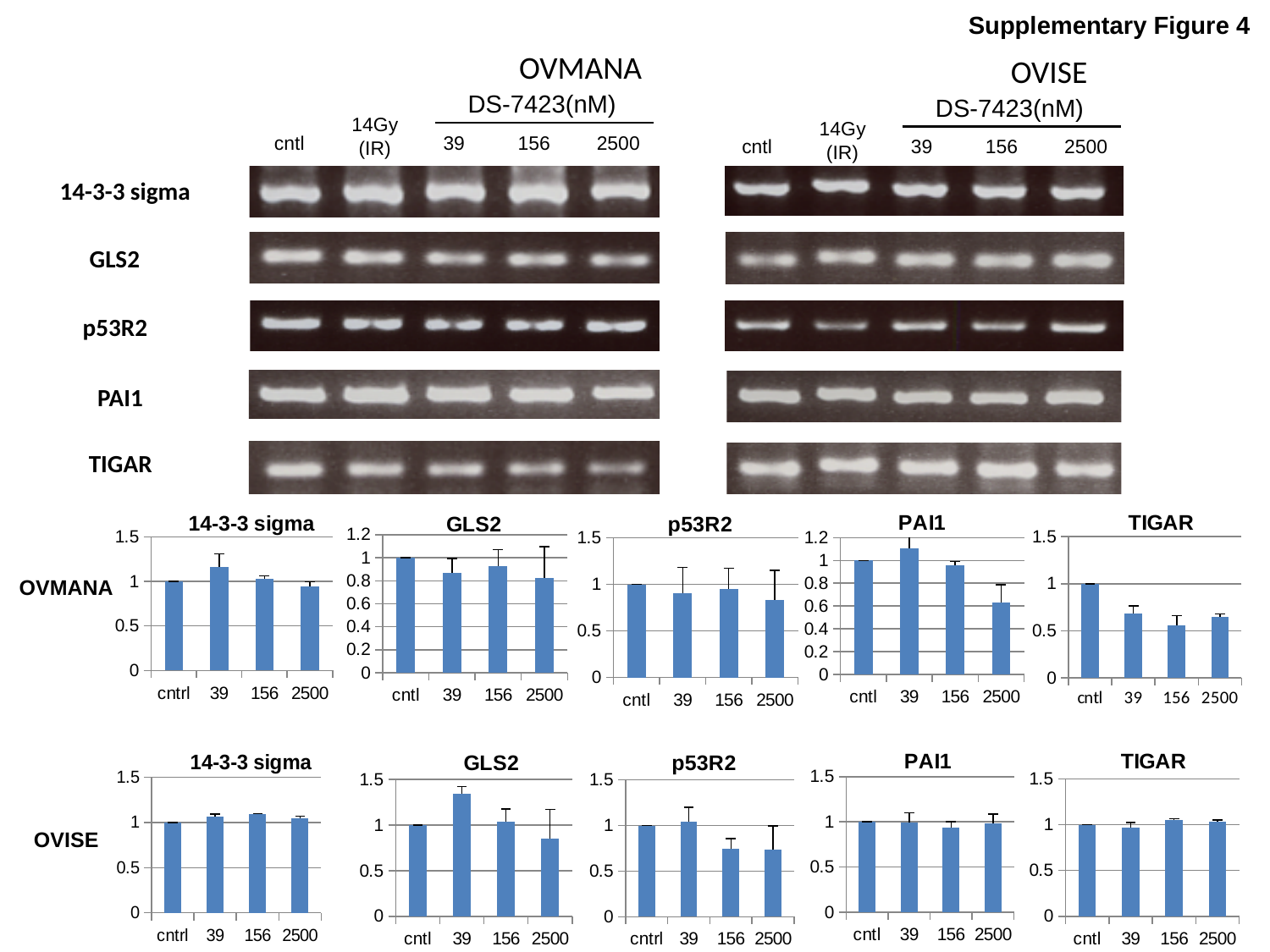
In the OVMANA PAI1 chart, do the values rise or fall going from 39 to 156 to 2500? fall In the OVMANA TIGAR chart, what is the value for cntrl? 1 What kind of chart is the OVMANA 14-3-3 sigma chart? bar chart How many bar charts are shown in the OVISE row? 5 In the OVMANA TIGAR chart, which category has the lowest bar? 156 In the OVMANA 14-3-3 sigma chart, which is larger, the value for 39 or the value for 2500? 39 In the OVMANA PAI1 chart, is the value for 2500 greater or less than 0.8? less How many categories are shown on the x axis of the OVMANA TIGAR chart? 4 In the OVISE GLS2 chart, which category has the highest bar? 39 In the OVMANA PAI1 chart, which category has the highest bar? 39 In the OVISE GLS2 chart, is the value for 39 greater or less than 1? greater In the OVISE p53R2 chart, which is larger, the value for 39 or the value for 156? 39